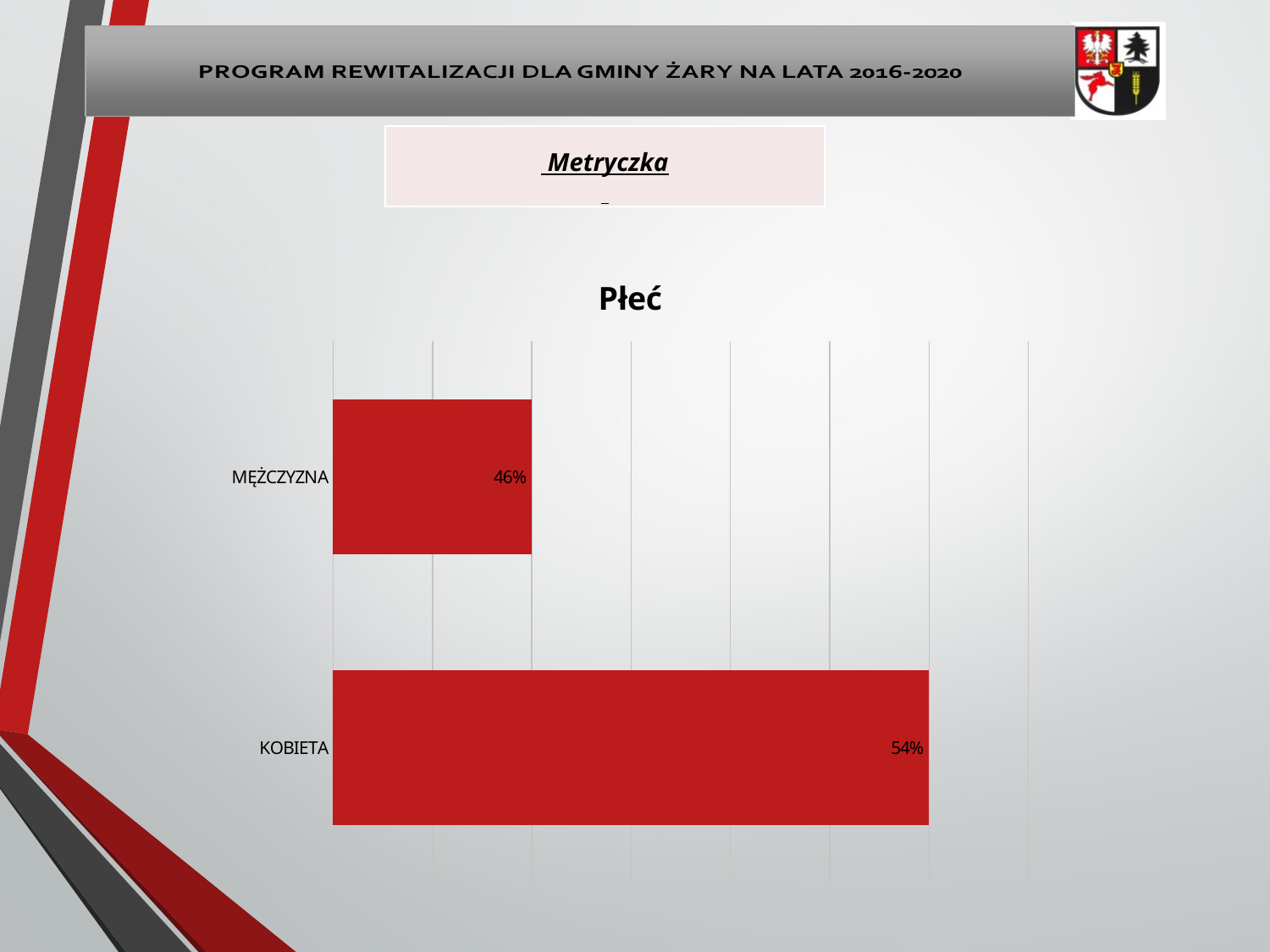
What is the value for MĘŻCZYZNA in the Płeć chart? 46% Which category has the lowest value in the Płeć chart? MĘŻCZYZNA Which is larger in the Płeć chart, the value for KOBIETA or for MĘŻCZYZNA? KOBIETA What colour are the bars in the Płeć chart? red What is the title of the chart on the slide? Płeć What is the difference between the values for KOBIETA and MĘŻCZYZNA in the Płeć chart? 8% What is the value for KOBIETA in the Płeć chart? 54% What is the total of the two values shown in the Płeć chart? 100% What kind of chart is the Płeć chart? bar chart How many categories are shown in the Płeć chart? 2 Which category has the highest value in the Płeć chart? KOBIETA